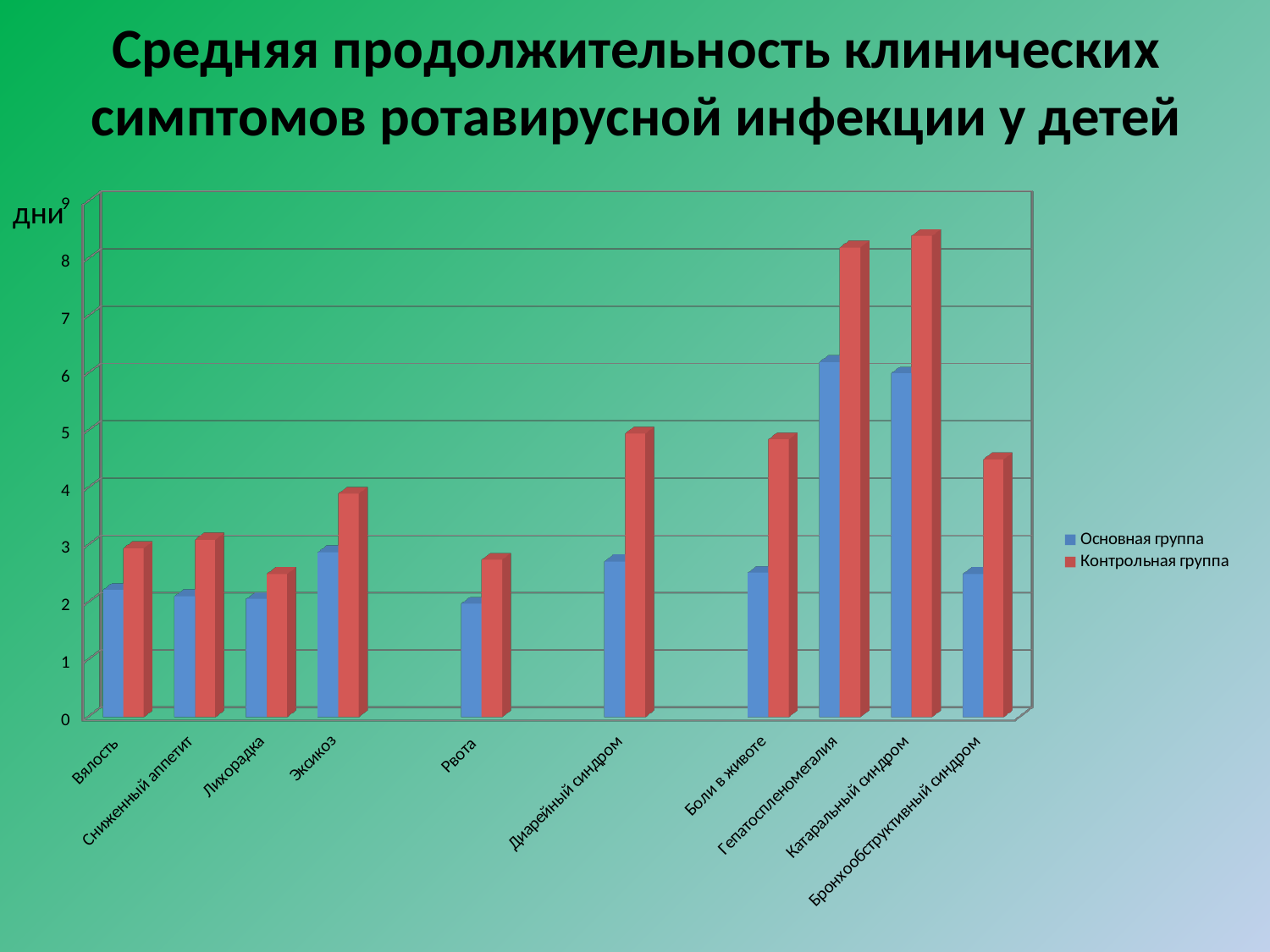
What kind of chart is shown on the slide? bar chart What unit label is shown next to the vertical axis? дни Is the value for Контрольная группа at Гепатоспленомегалия greater or less than 7? greater For Основная группа, which is larger, the value for Эксикоз or the value for Лихорадка? Эксикоз How many symptom categories are shown on the x axis? 10 Is the value for Основная группа at Катаральный синдром greater or less than 5? greater Which series is shown in red in the legend? Контрольная группа Is the value for Контрольная группа at Эксикоз greater or less than 3? greater How many series does the legend list? 2 For Диарейный синдром, which group has the larger value, Основная группа or Контрольная группа? Контрольная группа